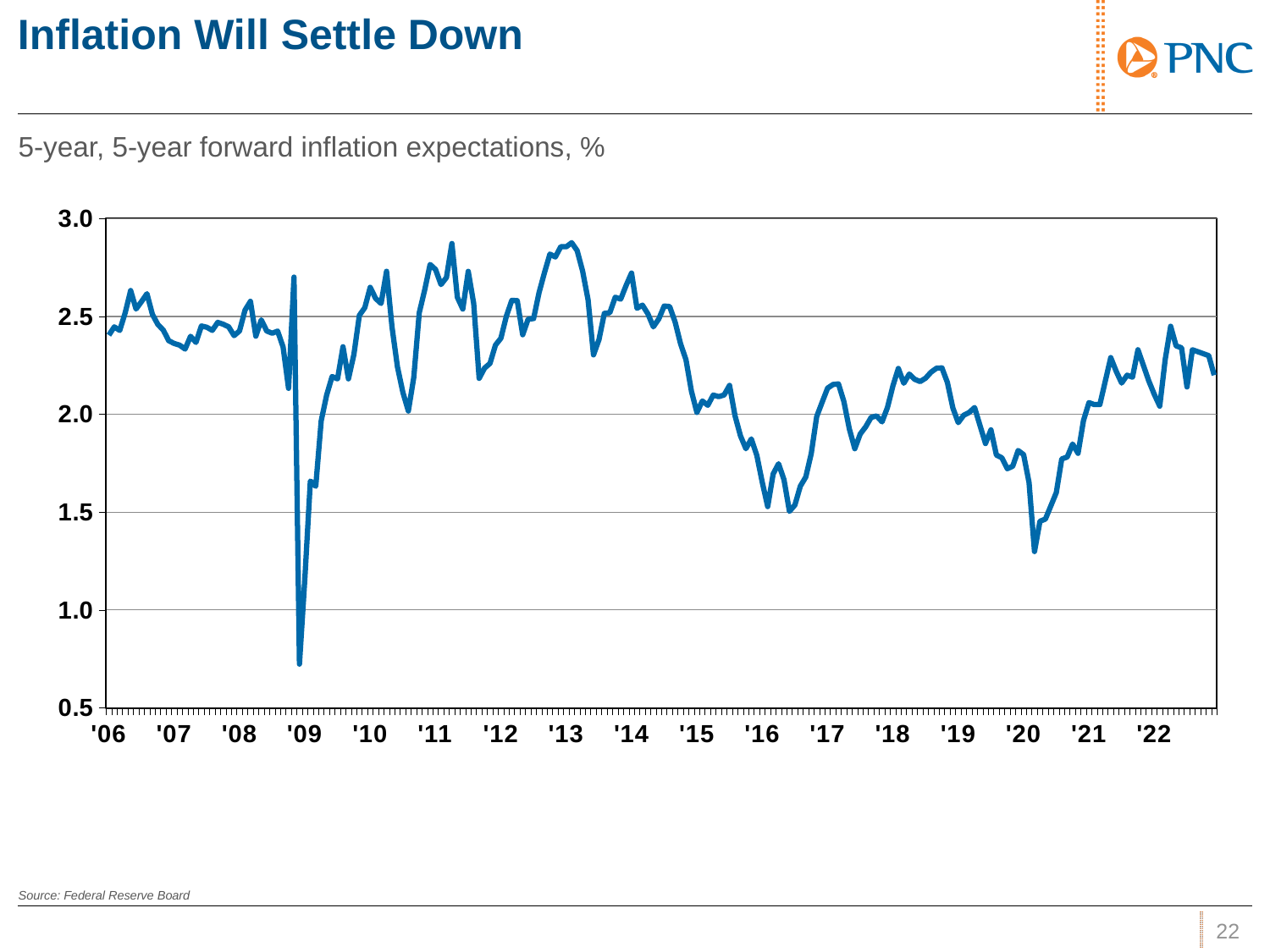
How many year labels are shown along the x axis? 17 What is the title of the slide containing the chart? Inflation Will Settle Down Is the value at the start of '06 greater or less than 2.0? greater What does the subtitle say the chart measures? 5-year, 5-year forward inflation expectations, % How many lines are plotted on the chart? 1 Is the value at the dip in early '20 greater or less than 1.5? less Does the line generally rise or fall between '14 and '16? fall Which is larger: the value at the start of '06 or the lowest value in '09? the value at the start of '06 What kind of chart is shown on the slide? line chart Is the lowest value of the line, in early '09, greater or less than 1.0? less